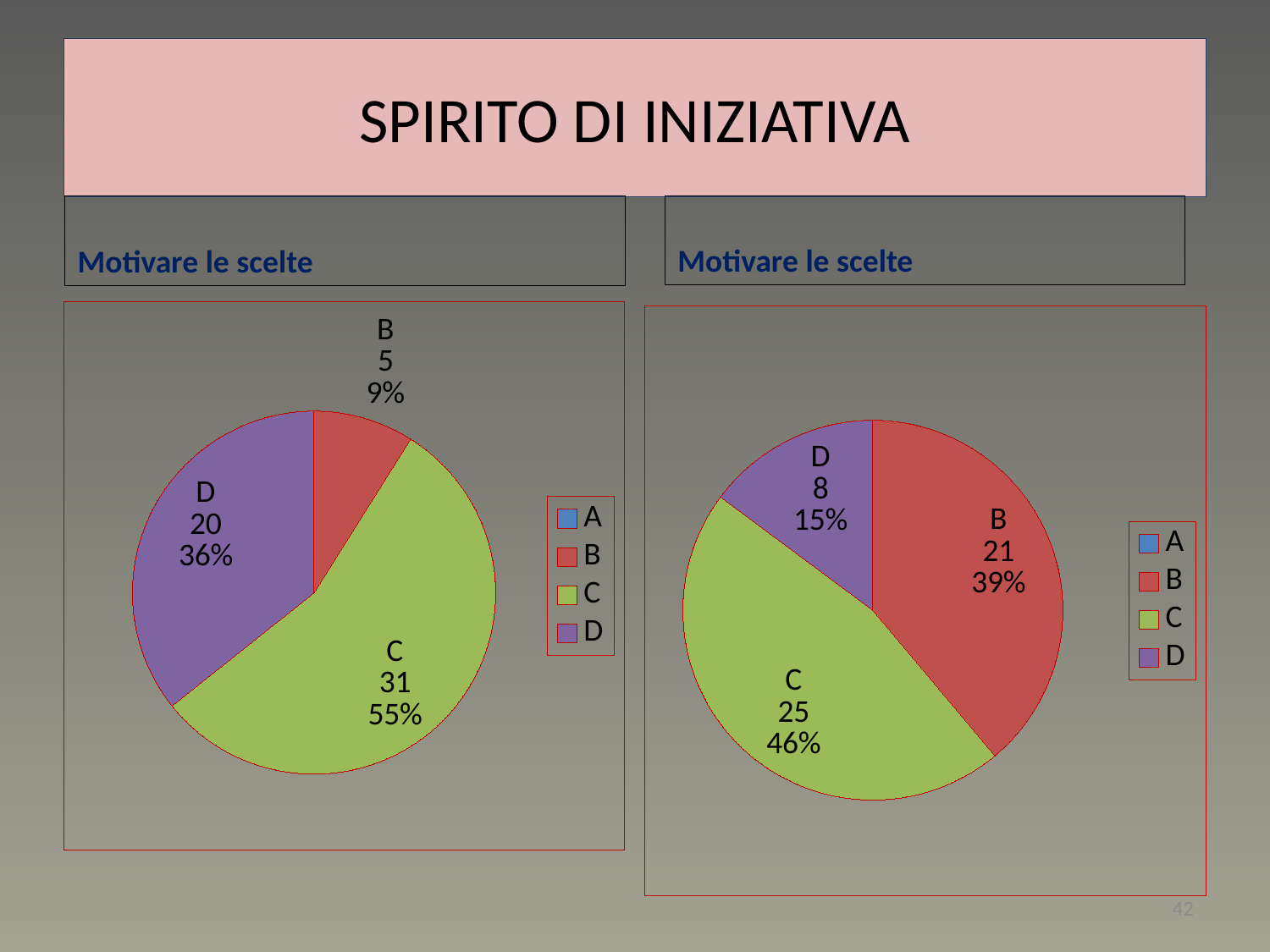
In the right pie chart, which category has the largest slice? C In the right pie chart, what percentage share does category D have? 15% What type of chart is shown on the right side of the slide? Pie chart In the right pie chart, which is larger, the value for B or the value for D? B In the left pie chart, which labelled slice is the smallest? B In the left pie chart, what is the value for category C? 31 In the left pie chart, what is the difference between the values for C and D? 11 In the left pie chart, which category has the largest slice? C In the right pie chart, what is the difference between the values for C and B? 4 In the left pie chart, what percentage share does category D have? 36% In the right pie chart, what is the value for category B? 21 How many entries does the legend of the left chart list? 4